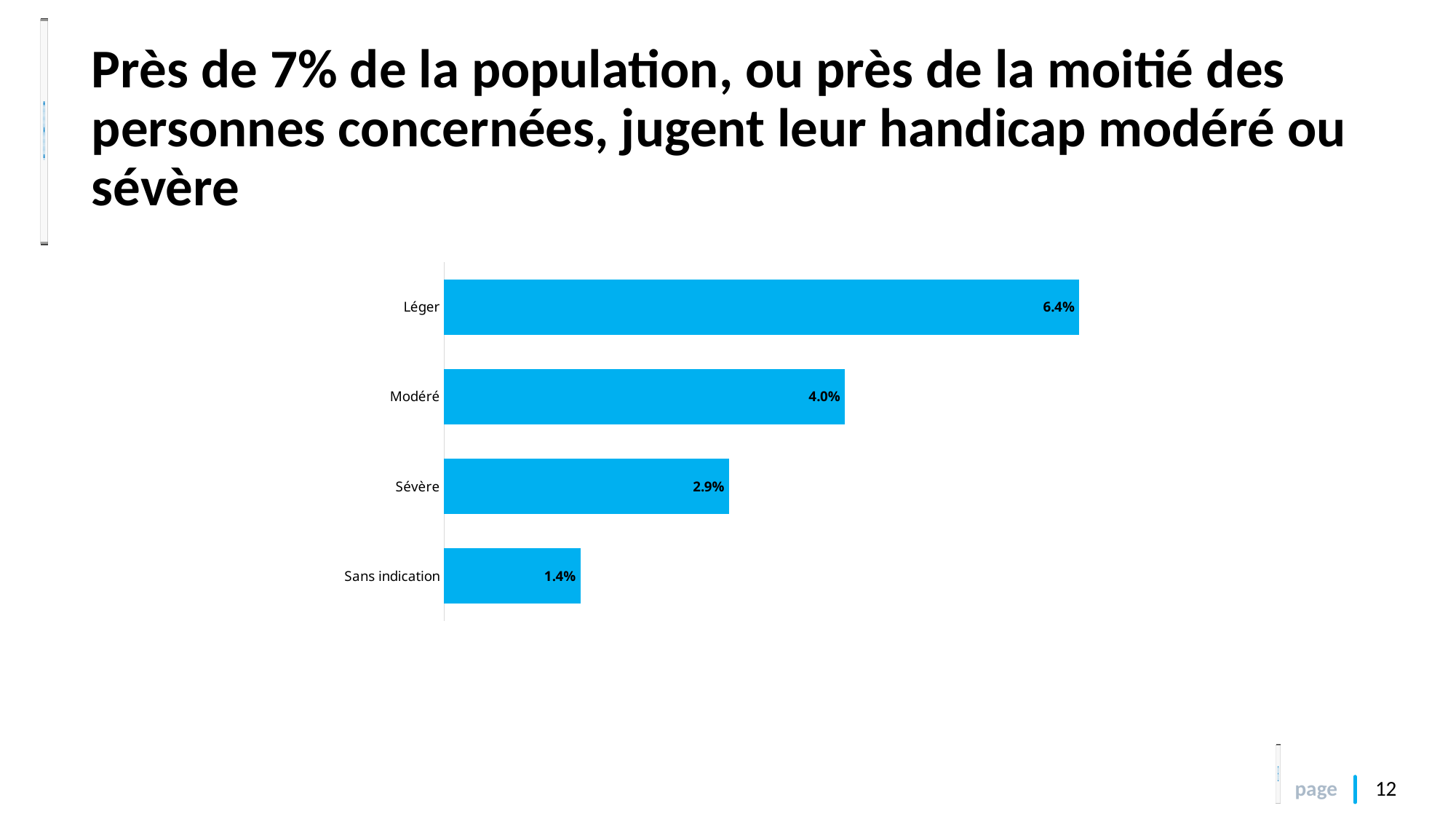
What is the value for Sévère? 2.9% Which category has the highest value? Léger What is the value for Léger? 6.4% What is the value for Sans indication? 1.4% What colour are the bars in the chart? Blue What is the difference between the values for Léger and Modéré? 2.4% What kind of chart is shown on the slide? Bar chart What is the value for Modéré? 4.0% Which is larger, the value for Modéré or the value for Sévère? Modéré What is the difference between the values for Sévère and Sans indication? 1.5% Which category has the lowest value? Sans indication How many categories are shown in the chart? 4